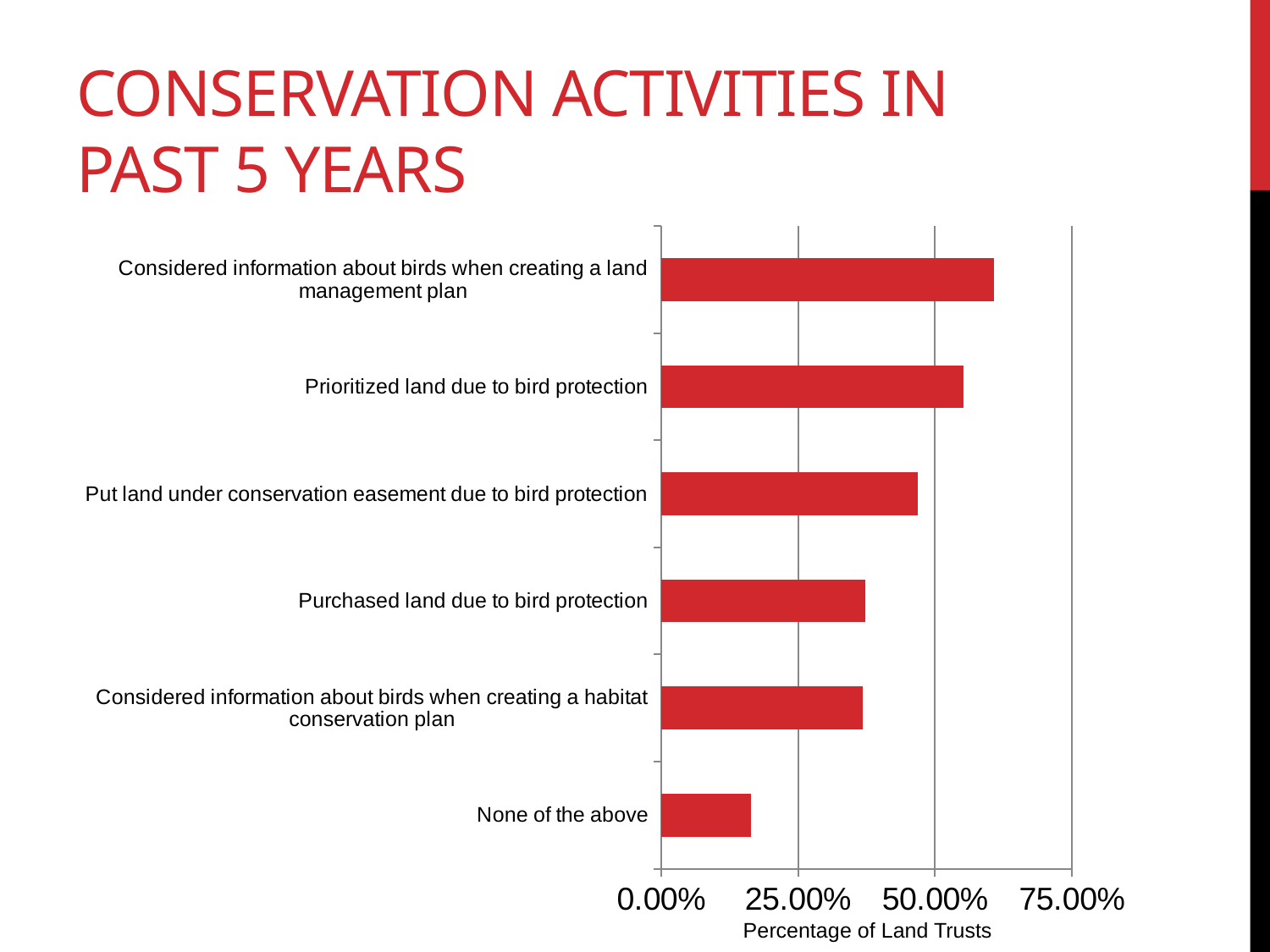
Is the value for "Prioritized land due to bird protection" greater or less than 50.00%? greater Is the value for "None of the above" greater or less than 25.00%? less How many categories (bars) does the chart show? 6 Which conservation activity has the highest percentage of land trusts? Considered information about birds when creating a land management plan Is the value for "Put land under conservation easement due to bird protection" greater or less than 50.00%? less What is the label of the horizontal axis? Percentage of Land Trusts What kind of chart is shown on the slide? Bar chart What is the title of the slide containing the chart? CONSERVATION ACTIVITIES IN PAST 5 YEARS Which category has the lowest percentage of land trusts? None of the above Which is larger: the value for "Prioritized land due to bird protection" or the value for "Purchased land due to bird protection"? Prioritized land due to bird protection